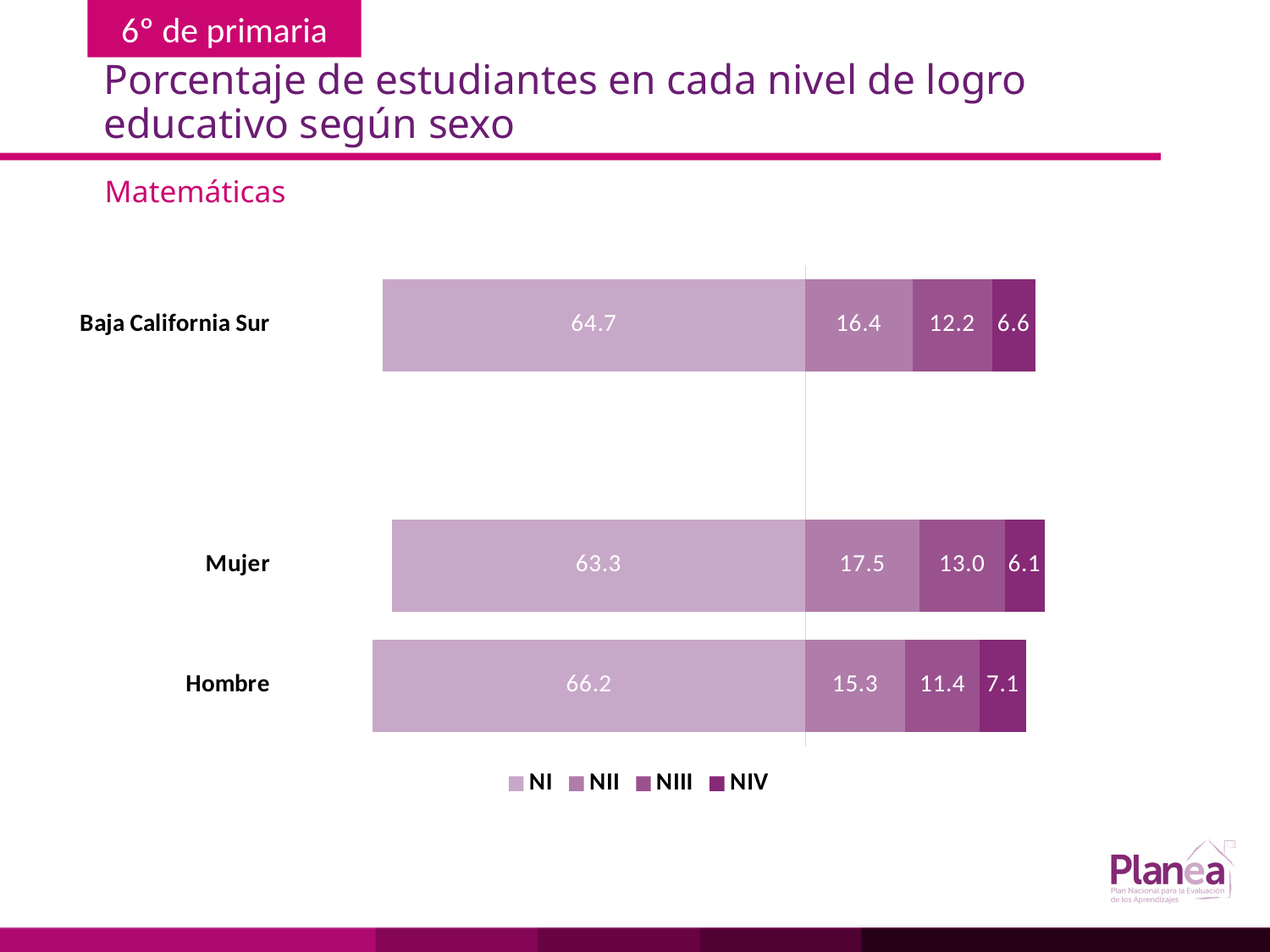
Which category has the highest NI value? Hombre What is the difference between the NI values for Hombre and Mujer? 2.9 What is the difference between the NII values for Mujer and Hombre? 2.2 What is the NI value for Mujer? 63.3 What is the NIII value for Mujer? 13.0 How many categories are shown on the chart? 3 Which is larger, the NIII value for Mujer or the NIII value for Hombre? Mujer How many series does the legend list? 4 What is the NII value for Baja California Sur? 16.4 Which category has the lowest NIV value? Mujer What is the NIV value for Hombre? 7.1 What kind of chart is shown on the slide? Stacked bar chart